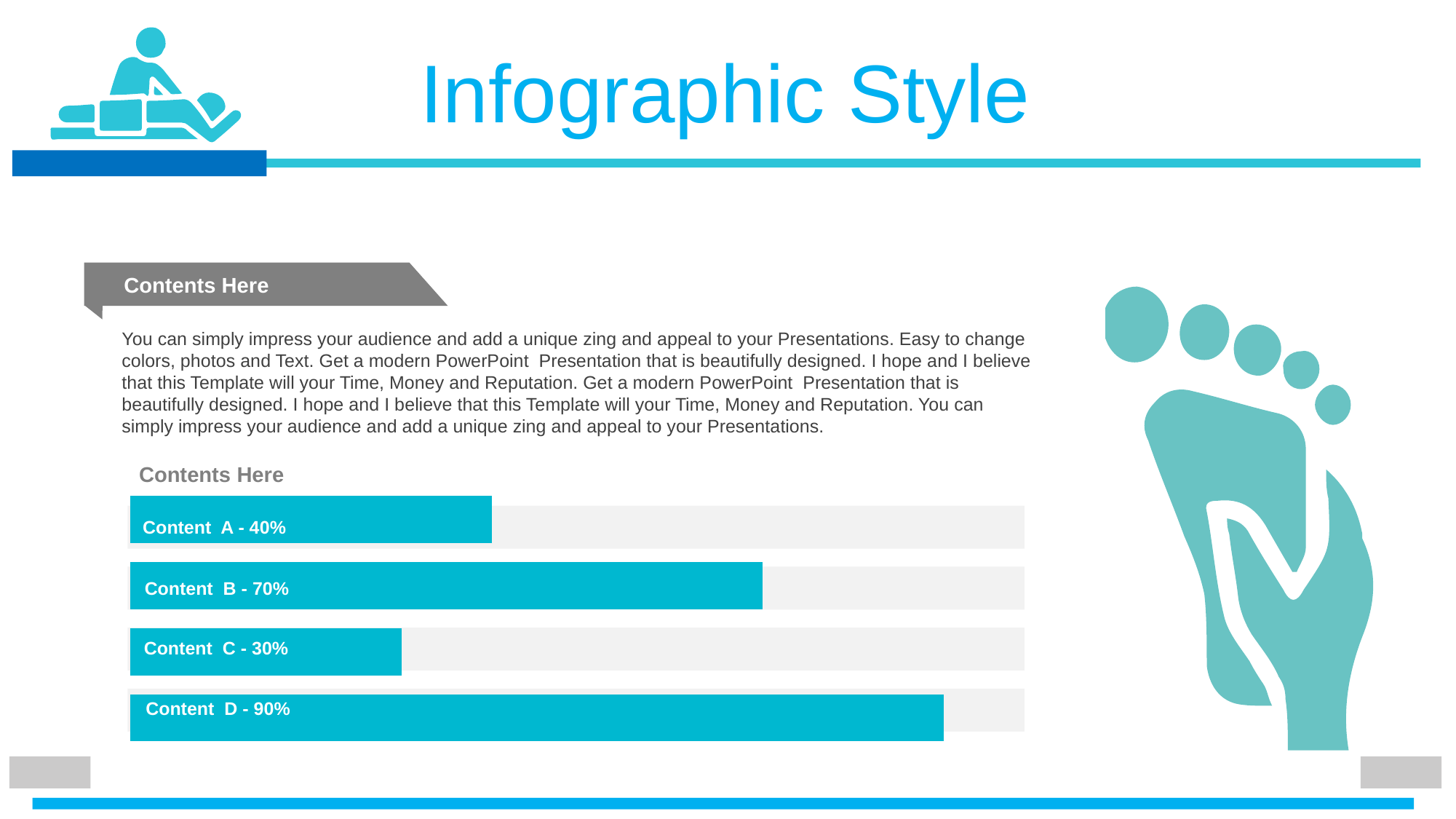
What is the value for Content A? 40% Which category has the lowest value? Content C What is the value for Content B? 70% What is the value for Content C? 30% What is the difference between the values for Content B and Content C? 40% What is the value for Content D? 90% Which category has the highest value? Content D How many categories are shown in the bar chart? 4 What kind of chart is shown on the slide? Bar chart What is the heading printed directly above the bar chart? Contents Here What is the difference between the values for Content D and Content A? 50% Which is larger, the value for Content A or the value for Content B? Content B